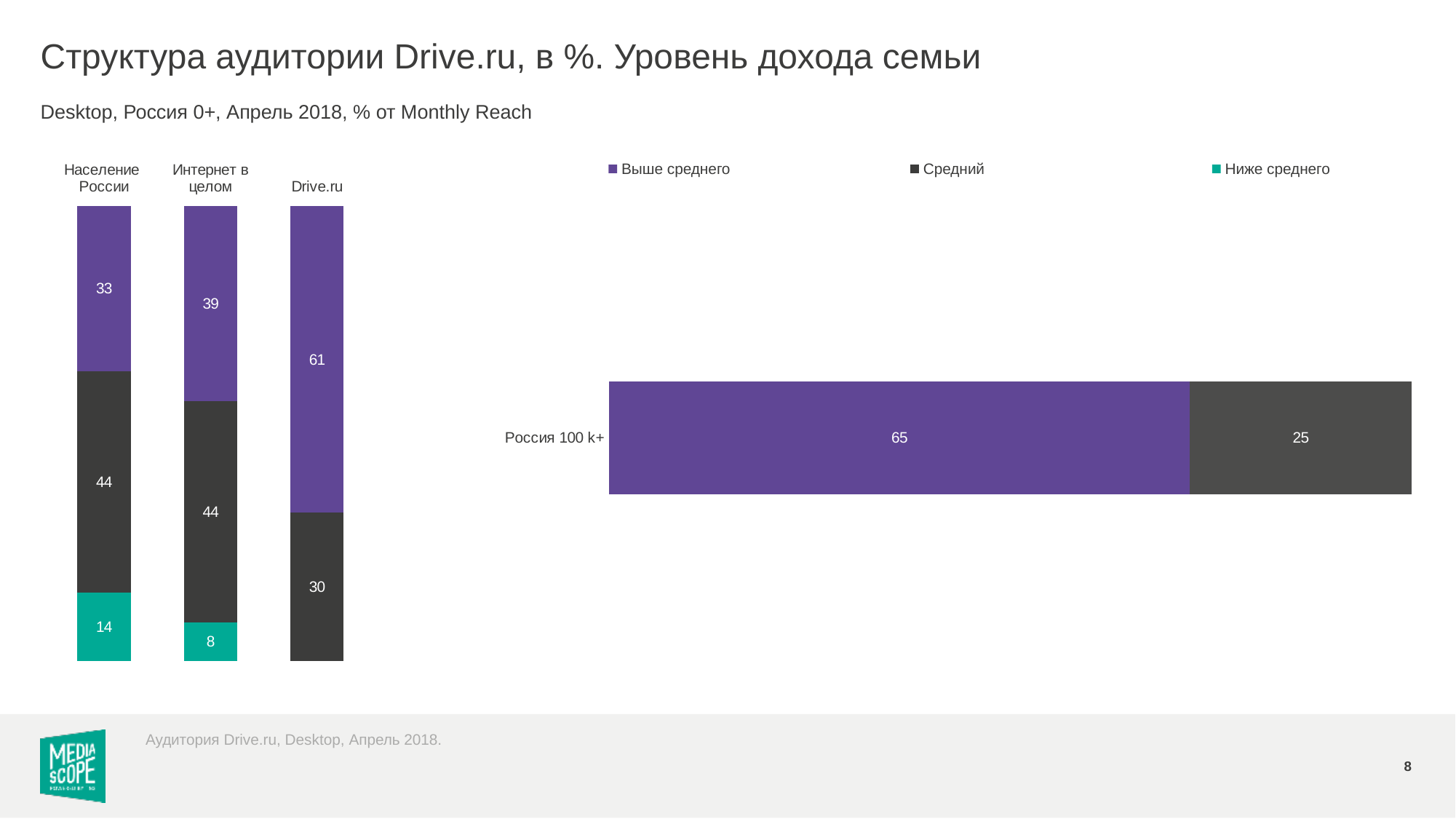
In the left stacked bar chart, what is the value of the 'Ниже среднего' segment for 'Население России'? 14 In the left stacked bar chart, what is the difference between the 'Выше среднего' values for Drive.ru and 'Население России'? 28 In the left stacked bar chart, which category has the lowest 'Ниже среднего' value? Интернет в целом In the left stacked bar chart, which category has the highest 'Выше среднего' value? Drive.ru In the left stacked bar chart, is the 'Средний' value larger for 'Население России' or for Drive.ru? Население России In the left stacked bar chart, what is the value of the 'Выше среднего' segment for Drive.ru? 61 How many series does the legend list? 3 In the right horizontal bar chart, what is the value of the 'Выше среднего' segment for 'Россия 100 k+'? 65 In the left stacked bar chart, what is the value of the 'Средний' segment for 'Интернет в целом'? 44 How many categories are shown in the left stacked bar chart? 3 In the right horizontal bar chart, what is the total of the two labelled segments for 'Россия 100 k+'? 90 What type of chart is the right chart showing 'Россия 100 k+'? Bar chart